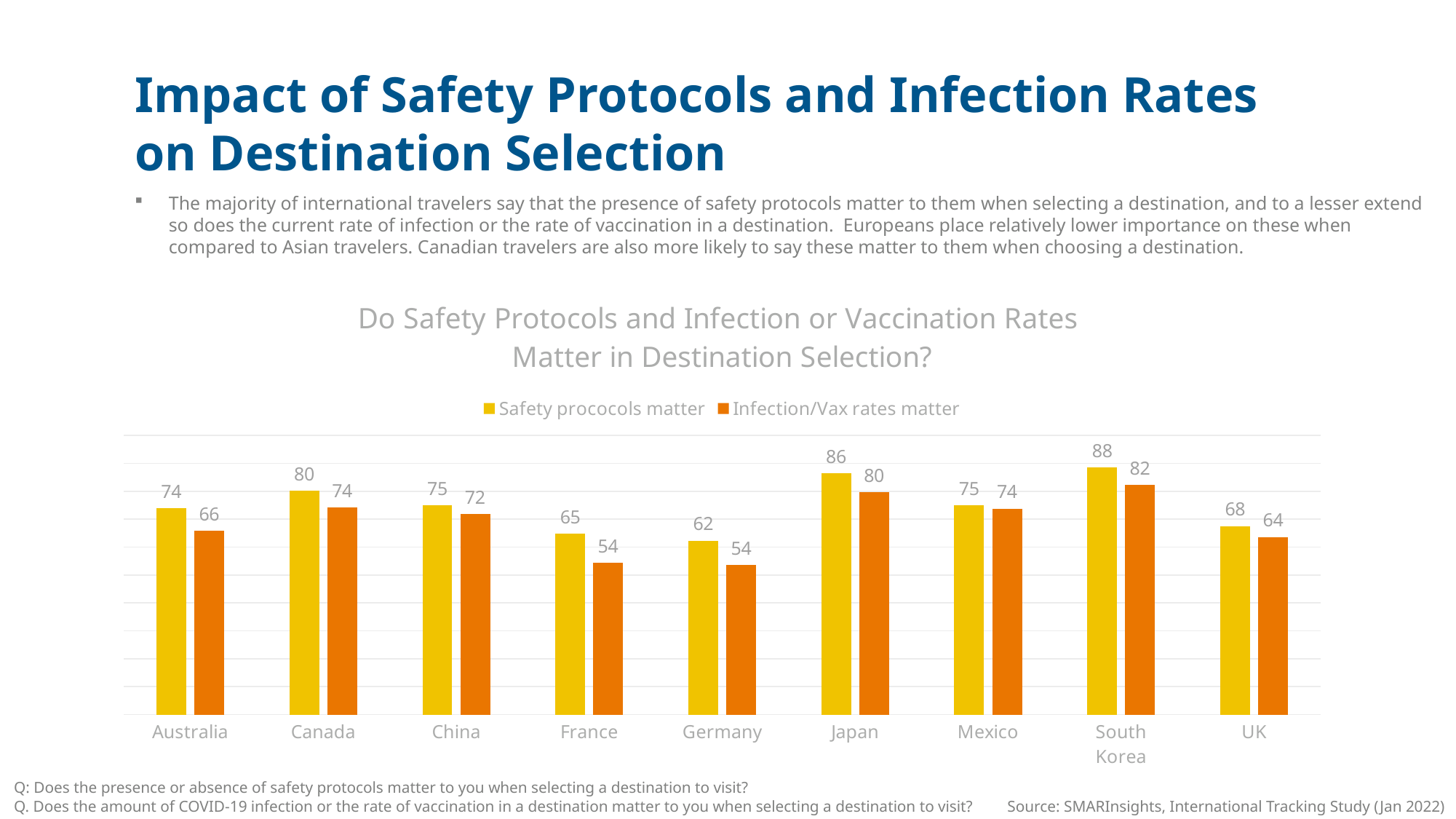
What is the difference between the 'Safety prococols matter' and 'Infection/Vax rates matter' values for Australia? 8 What is the value for 'Infection/Vax rates matter' for France? 54 Which country has the lowest value for 'Safety prococols matter'? Germany Which colour represents the 'Infection/Vax rates matter' series? Orange How many series does the legend list? 2 Which country has the highest value for 'Safety prococols matter'? South Korea How many countries are shown on the x axis? 9 What kind of chart is shown on the slide? Bar chart What is the value for 'Safety prococols matter' for Japan? 86 What is the title of the chart? Do Safety Protocols and Infection or Vaccination Rates Matter in Destination Selection? Which is larger: the 'Safety prococols matter' value for China or for the UK? China Which is larger: the 'Infection/Vax rates matter' value for Canada or for Mexico? Canada and Mexico are equal (74)